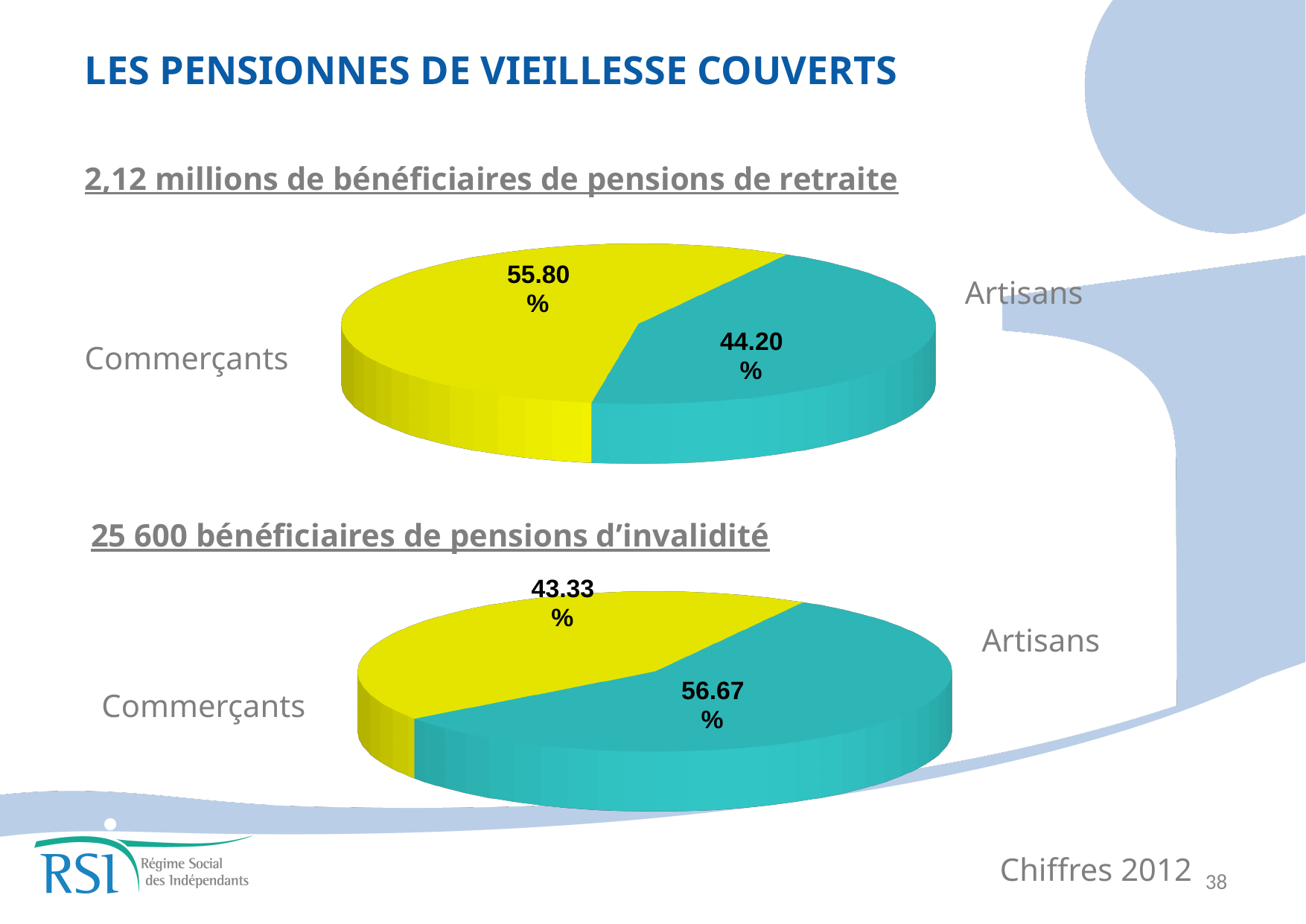
In the bottom pie chart (pensions d'invalidité), what share is labelled for Commerçants? 43.33% How many categories does each pie chart on the slide show? 2 In the top pie chart (pensions de retraite), what share is labelled for Commerçants? 55.80% In the bottom pie chart (pensions d'invalidité), is the share for Artisans larger or smaller than the share for Commerçants? larger In the bottom pie chart (pensions d'invalidité), what is the difference in percentage points between the Artisans and Commerçants shares? 13.34 In the top pie chart (pensions de retraite), which category has the larger share? Commerçants In the top pie chart (pensions de retraite), what is the difference in percentage points between the Commerçants and Artisans shares? 11.60 In the bottom pie chart (pensions d'invalidité), what share is labelled for Artisans? 56.67% In the top pie chart (pensions de retraite), what share is labelled for Artisans? 44.20% In the top pie chart (pensions de retraite), which colour represents Artisans? Teal (blue-green) In the bottom pie chart (pensions d'invalidité), which category has the smaller share? Commerçants What type of chart is used on this slide? Pie chart